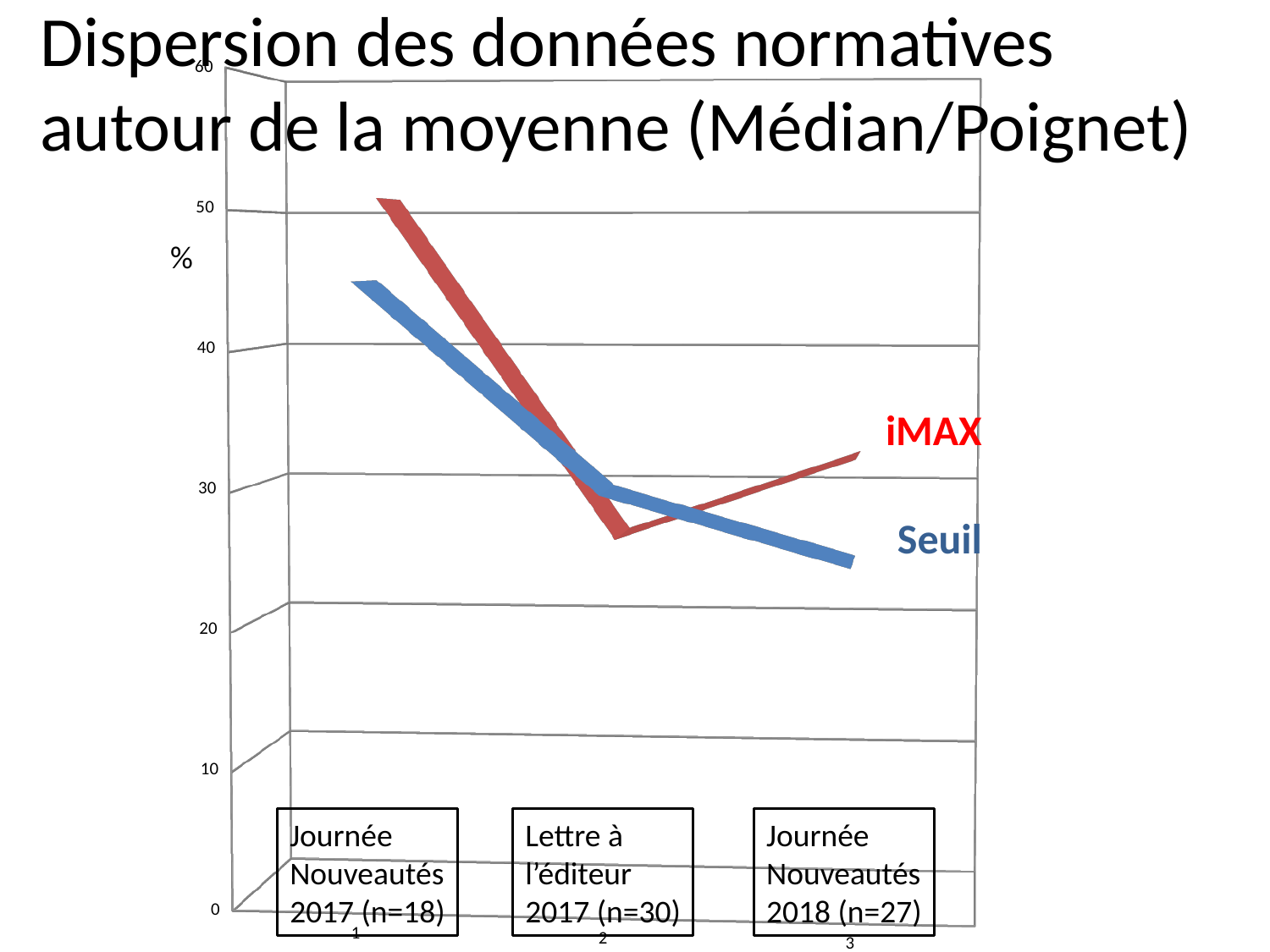
What unit is shown on the y axis of the chart? % Is the iMAX value for Journée Nouveautés 2017 (n=18) greater or less than 40? greater Does the Seuil series rise or fall from left to right across the x axis? Fall What are the names of the two series on the chart? iMAX and Seuil For which category is the iMAX series at its lowest? Lettre à l'éditeur 2017 (n=30) Is the iMAX value for Lettre à l'éditeur 2017 (n=30) greater or less than 30? less At Journée Nouveautés 2018 (n=27), which series has the higher value, iMAX or Seuil? iMAX Is the Seuil value for Journée Nouveautés 2018 (n=27) greater or less than 30? less How many series are plotted on the chart? 2 At Journée Nouveautés 2017 (n=18), which series has the higher value, iMAX or Seuil? iMAX What kind of chart is shown on the slide? Line chart How many categories are shown along the x axis? 3